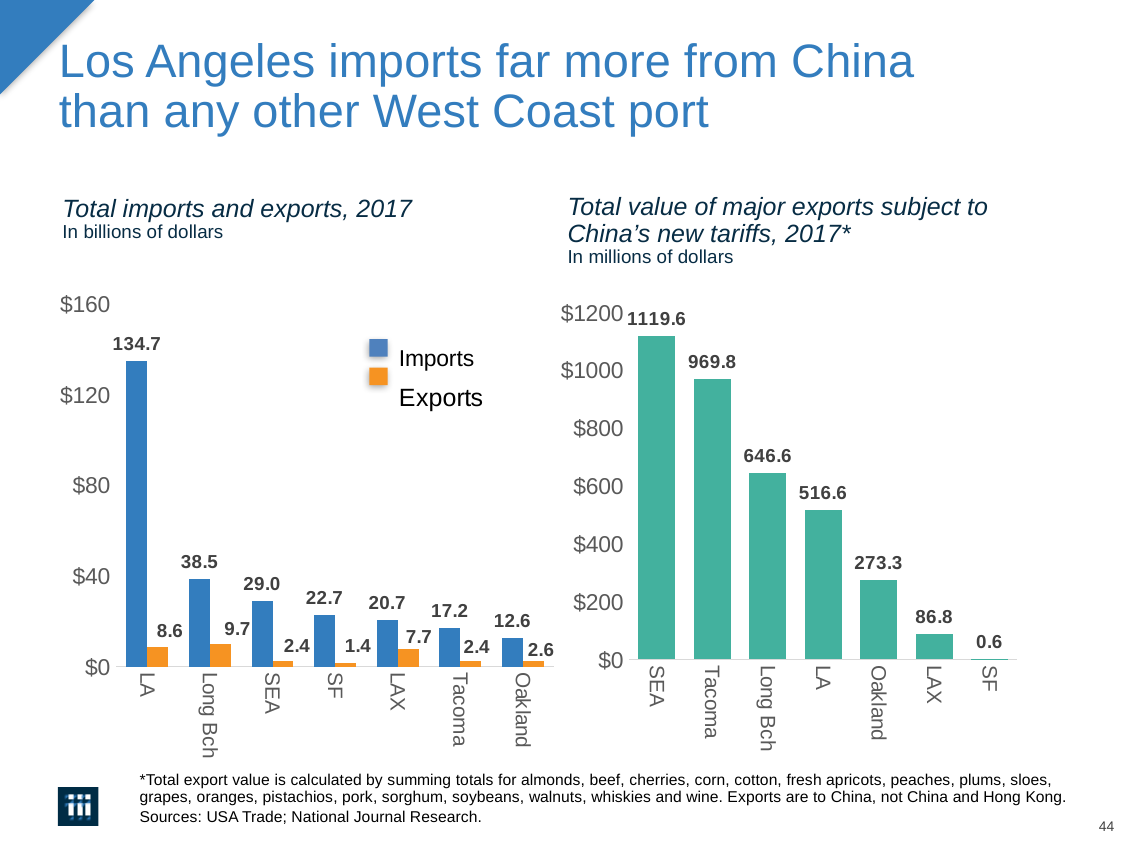
In the 'Total imports and exports, 2017' chart, what is the difference between the Imports and Exports values for LAX? 13.0 In the 'Total value of major exports subject to China's new tariffs, 2017' chart, do the values rise or fall from left to right? fall In the 'Total imports and exports, 2017' chart, how many series does the legend list? 2 In the 'Total value of major exports subject to China's new tariffs, 2017' chart, how many ports are shown? 7 In the 'Total value of major exports subject to China's new tariffs, 2017' chart, what is the value for Tacoma? 969.8 In the 'Total imports and exports, 2017' chart, what is the Imports value for LA? 134.7 In the 'Total imports and exports, 2017' chart, is the Imports value for SEA greater or less than $40? less In the 'Total imports and exports, 2017' chart, what is the Exports value for Long Bch? 9.7 In the 'Total value of major exports subject to China's new tariffs, 2017' chart, which port has the highest value? SEA In the 'Total imports and exports, 2017' chart, which port has the lowest Imports value? Oakland What kind of chart is the 'Total value of major exports subject to China's new tariffs, 2017' chart? bar chart In the 'Total value of major exports subject to China's new tariffs, 2017' chart, which port has the lowest value? SF